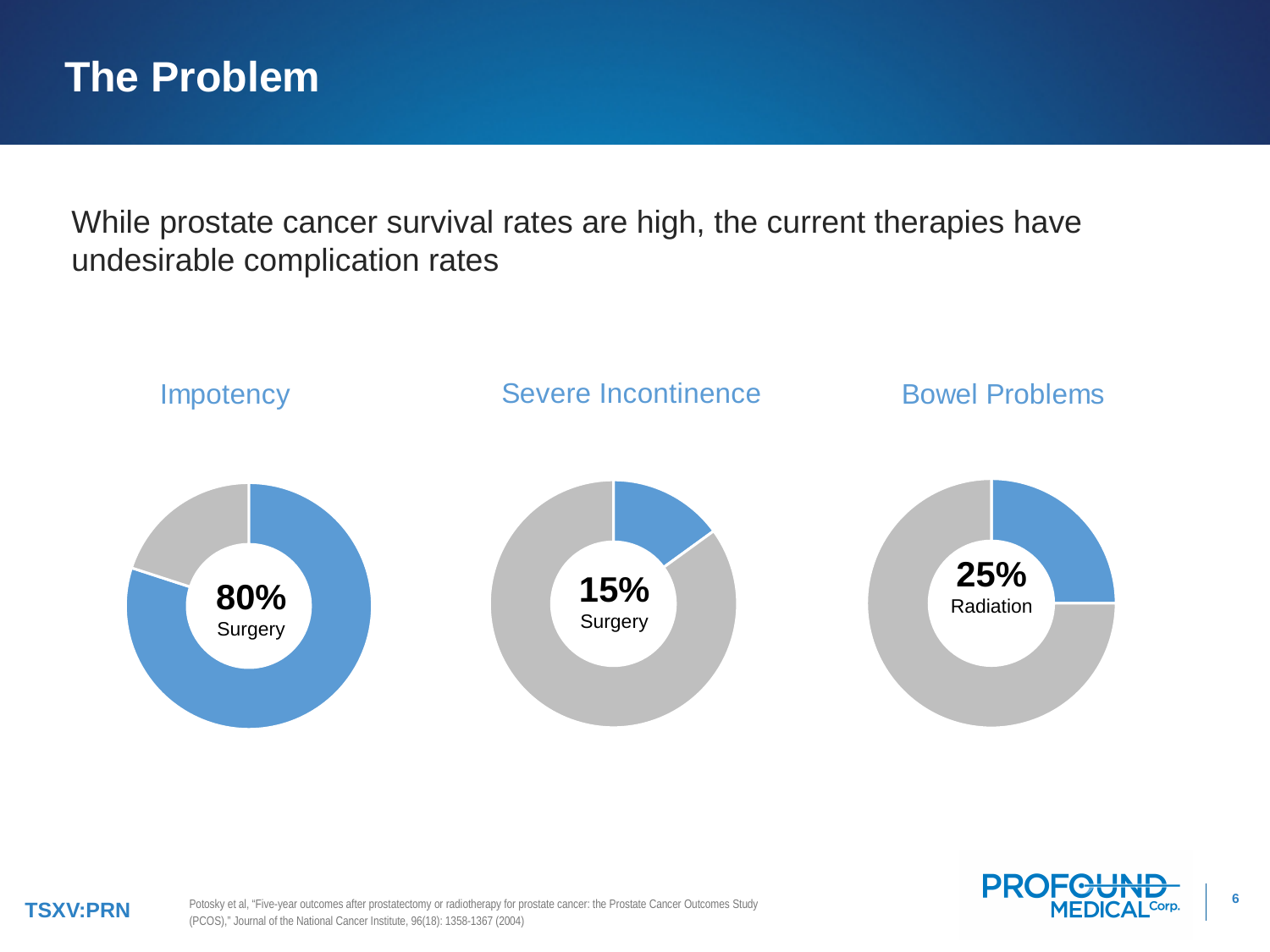
What percentage is shown in the centre of the Bowel Problems chart? 25% What kind of chart is used for Impotency, Severe Incontinence and Bowel Problems? Donut (pie) chart What percentage is shown in the centre of the Impotency chart? 80% Which therapy is labelled in the centre of the Bowel Problems chart? Radiation How many donut charts are shown on the slide? 3 Which of the three charts shows the lowest percentage? Severe Incontinence Which therapy is labelled in the centre of the Impotency chart? Surgery Which of the three charts shows the highest percentage? Impotency Which is larger, the percentage in the Bowel Problems chart or the percentage in the Severe Incontinence chart? Bowel Problems What percentage is shown in the centre of the Severe Incontinence chart? 15% What is the difference between the percentage in the Impotency chart and the percentage in the Severe Incontinence chart? 65% In the Severe Incontinence chart, what colour is the slice representing the 15% value? Blue